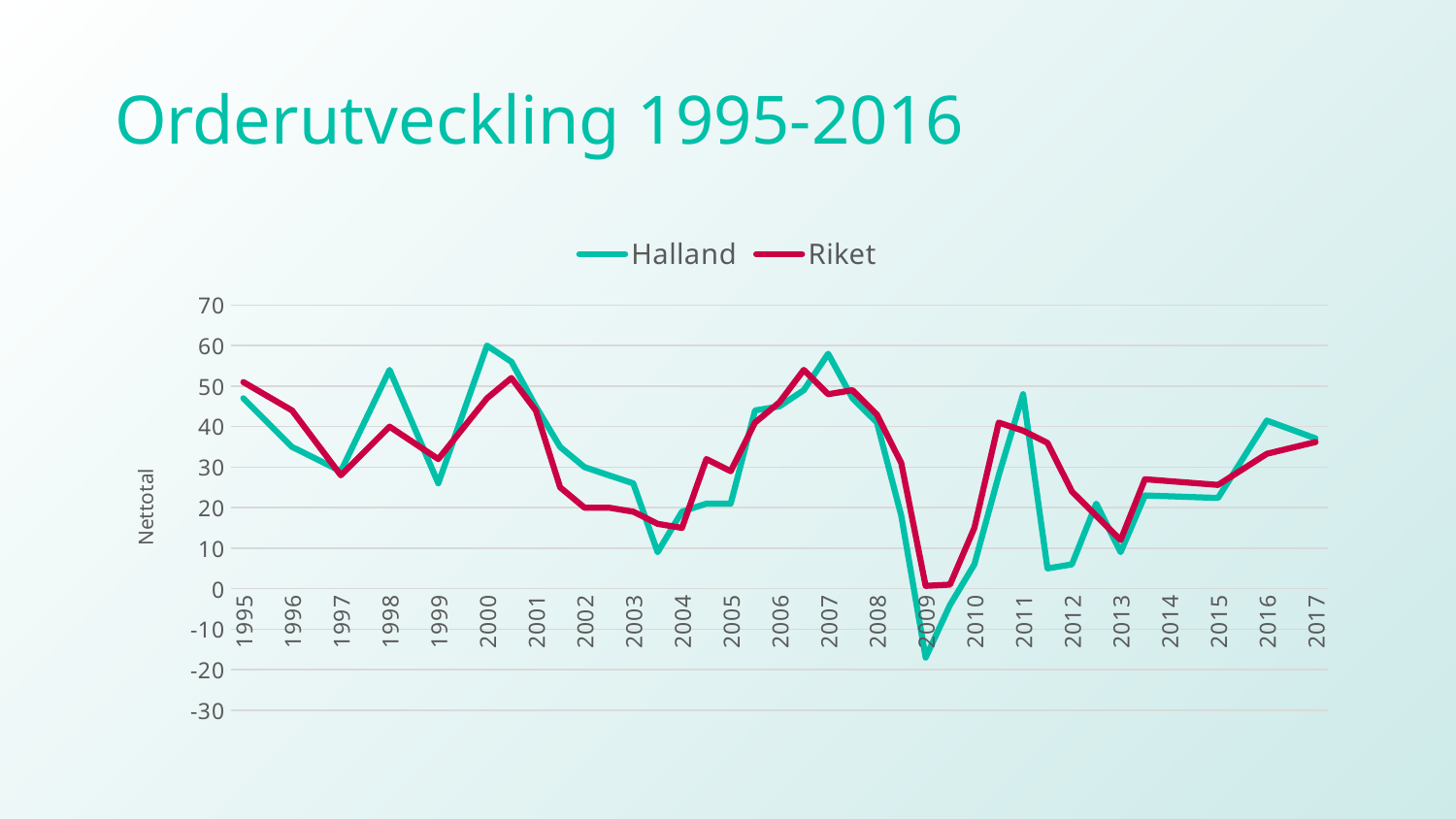
What is the title of the chart on the slide? Orderutveckling 1995-2016 How many year labels are shown on the x axis? 23 How many series does the legend list? 2 Is the value for Halland in 2000 greater or less than 50? greater In which year does the Halland series reach its lowest value? 2009 Which two series are shown in the legend? Halland and Riket Is the value for Riket in 2004 greater or less than 20? less What kind of chart is shown on the slide? line chart In 2009, which series has the higher value, Halland or Riket? Riket In 2011, which series has the higher value, Halland or Riket? Halland In which year does the Riket series reach its lowest value? 2009 Is the value for Halland in 2009 greater or less than -10? less